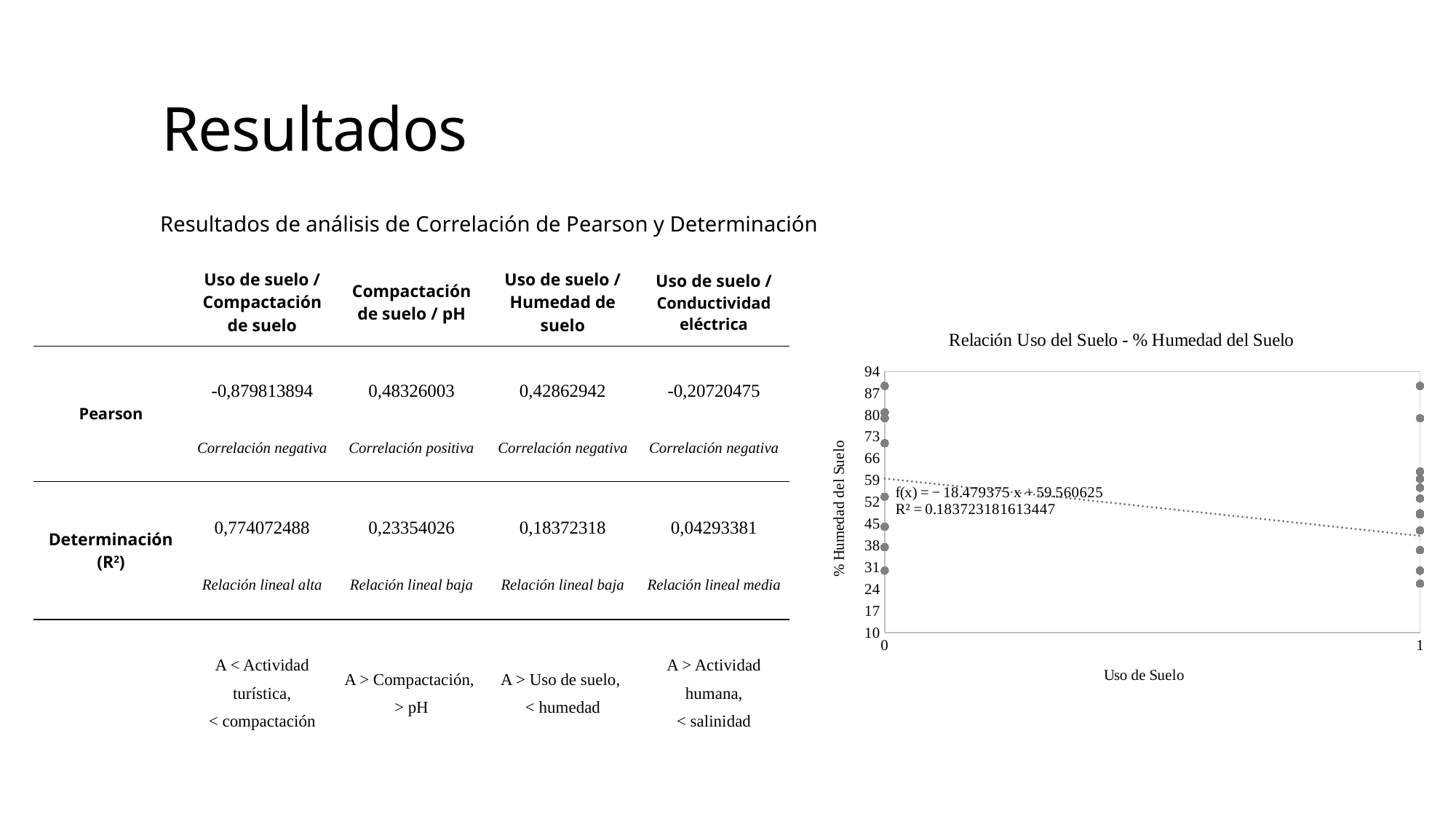
What is the highest tick value shown on the y axis of the chart? 94 What is the trendline equation shown on the chart? f(x) = − 18.479375 x + 59.560625 Does the trendline on the chart rise or fall as Uso de Suelo increases from 0 to 1? fall What is the R² value shown on the chart? 0.183723181613447 How many distinct x-axis values (Uso de Suelo) are the points plotted at? 2 What kind of chart is shown on the slide? scatter chart What is the lowest tick value shown on the y axis of the chart? 10 What is the label of the y axis of the chart? % Humedad del Suelo Is the highest point at Uso de Suelo = 1 greater or less than 80? greater Is the lowest point at Uso de Suelo = 0 greater or less than 38? less Is the highest point at Uso de Suelo = 0 greater or less than 80? greater What is the title of the chart? Relación Uso del Suelo - % Humedad del Suelo